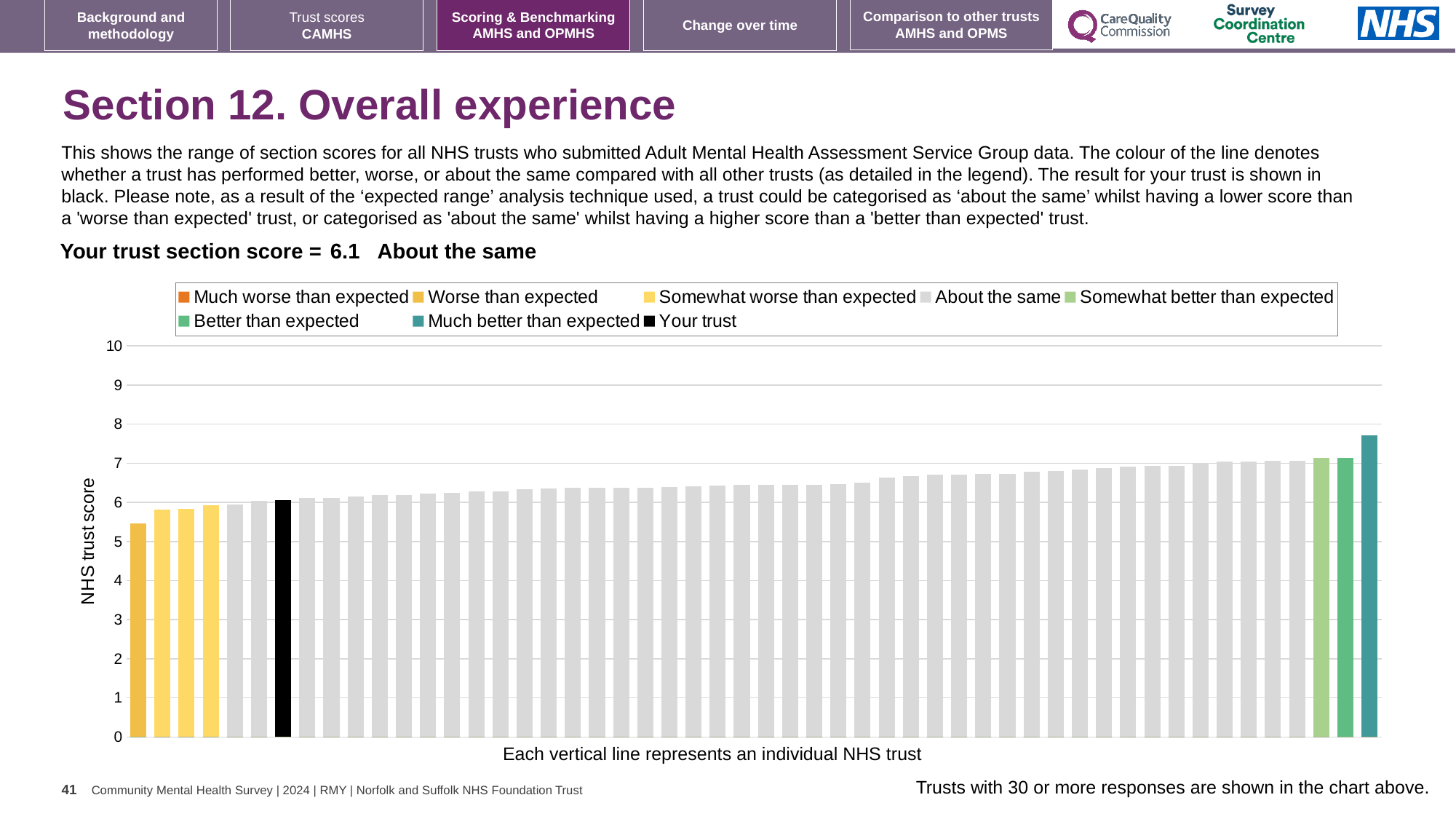
Is the value of the shortest bar (the leftmost trust) greater or less than 6? less Which category is your trust placed in for this section? About the same What colour is used for the 'Your trust' bar in the chart? Black Is the bar for your trust taller or shorter than the tallest bar in the chart? Shorter What is the section score for your trust shown on the slide? 6.1 Is the value for your trust (the black bar) greater or less than 5? greater Is the value of the tallest bar (the teal 'Much better than expected' trust) greater or less than 7? greater How many entries does the chart legend list? 8 What kind of chart is shown on the slide? Bar chart What is the label on the vertical axis of the chart? NHS trust score Which legend category does the tallest bar in the chart belong to? Much better than expected Do the bar values rise or fall from left to right across the chart? Rise